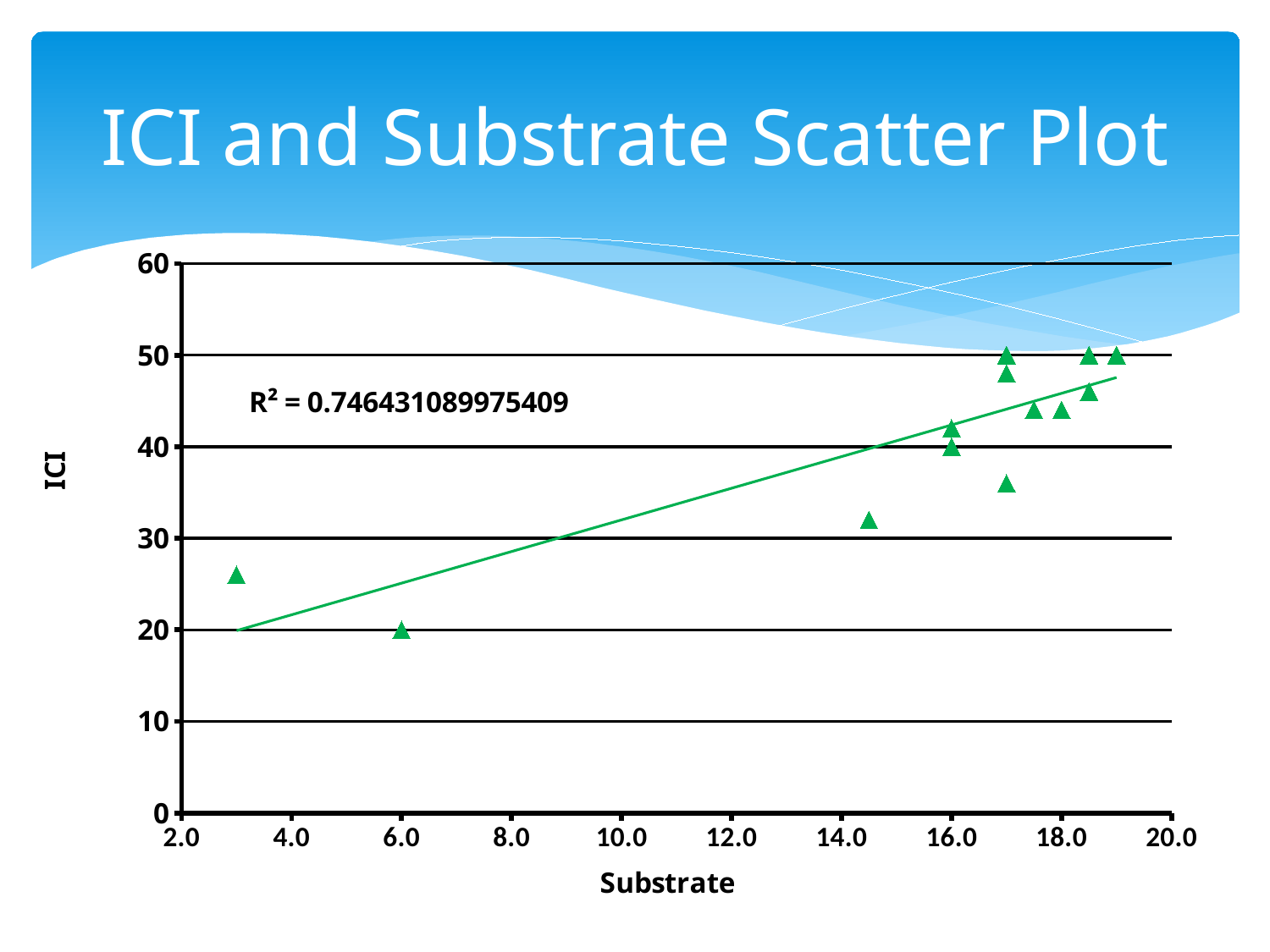
What is the title of the chart? ICI and Substrate Scatter Plot Is the ICI value for the point at Substrate 6.0 greater or less than 30? less Is the ICI value for the point at Substrate 3.0 greater or less than 20? greater Which point has a higher ICI value: the one at Substrate 3.0 or the one at Substrate 6.0? Substrate 3.0 What is the highest value shown on the ICI (y) axis? 60 Do the ICI values generally rise or fall as Substrate increases along the x axis? Rise At which Substrate value is the point with the lowest ICI located? 6.0 Is the ICI value for the point at Substrate 14.5 greater or less than 30? greater What kind of chart is shown on the slide? Scatter plot What R² value is printed on the chart? R² = 0.746431089975409